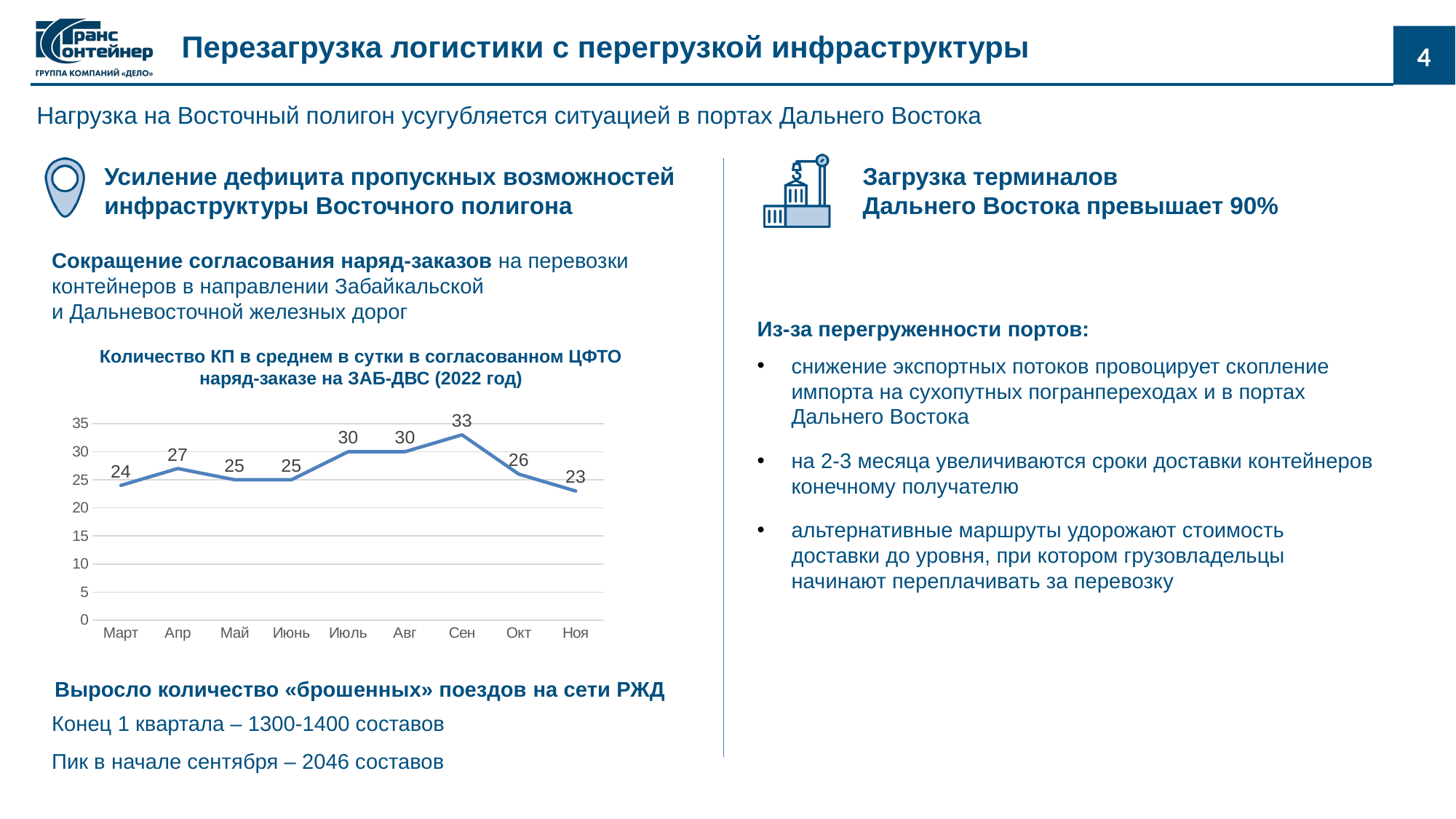
What is the title of the chart? Количество КП в среднем в сутки в согласованном ЦФТО наряд-заказе на ЗАБ-ДВС (2022 год) What is the difference between the values for Апр and Март? 3 What kind of chart is shown on the slide? line chart What is the value for Март (March) on the chart? 24 Which is larger, the value for Окт or the value for Май? Окт Which month has the highest value on the chart? Сен What is the value for Ноя (November) on the chart? 23 What is the difference between the values for Сен and Ноя? 10 How many months are plotted on the chart? 9 Do the values rise or fall from Сен to Ноя? fall What is the value for Сен (September) on the chart? 33 Which month has the lowest value on the chart? Ноя